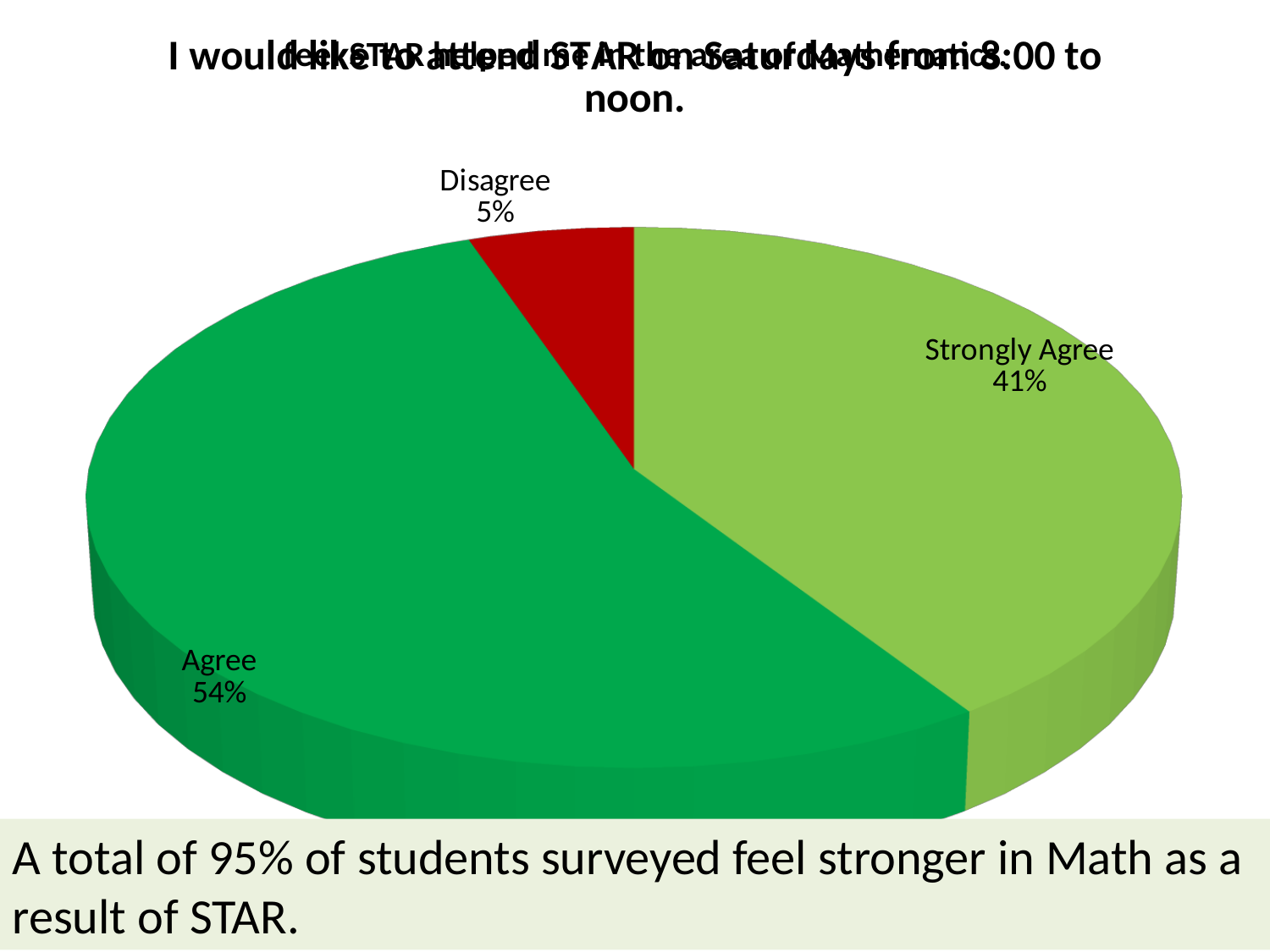
What colour is the Disagree slice? Red What is the combined share of the Agree and Strongly Agree slices? 95% Which slice of the pie is the largest? Agree What is the difference in percentage points between the Agree and Strongly Agree slices? 13 Which slice of the pie is the smallest? Disagree What is the difference in percentage points between the Strongly Agree and Disagree slices? 36 What percentage of the pie is labelled Agree? 54% What percentage of the pie is labelled Strongly Agree? 41% What kind of chart is shown on the slide? Pie chart What percentage of the pie is labelled Disagree? 5% How many slices does the pie chart have? 3 Which is larger, the Agree slice or the Strongly Agree slice? Agree